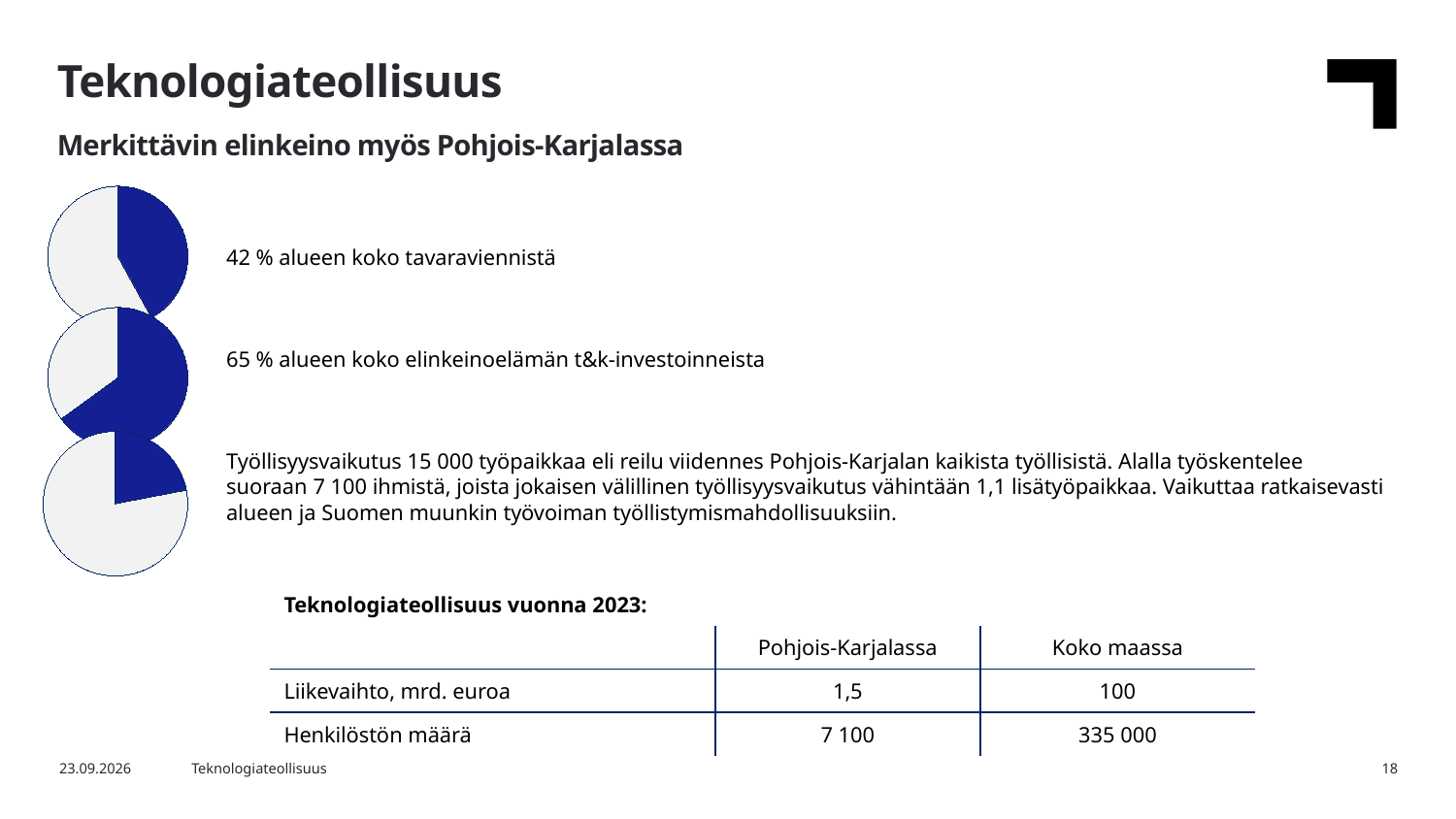
What kind of charts are shown on the left side of the slide? Pie charts Is the blue slice larger in the top pie chart or in the middle pie chart? Middle Is the blue share in the middle pie chart greater or less than 50%? greater What colour is used for the highlighted slice in the pie charts? Blue Is the blue share in the bottom pie chart greater or less than 50%? less Which pie chart has the smallest blue slice: the top, middle or bottom one? Bottom How many slices does each pie chart have? 2 In the top pie chart, what share of the region's total goods exports does the blue slice represent? 42 % How many pie charts are on the slide? 3 What is the difference in percentage points between the blue shares of the middle and top pie charts? 23 percentage points Which pie chart has the largest blue slice: the top, middle or bottom one? Middle In the middle pie chart, what share of the region's business R&D investments does the blue slice represent? 65 %